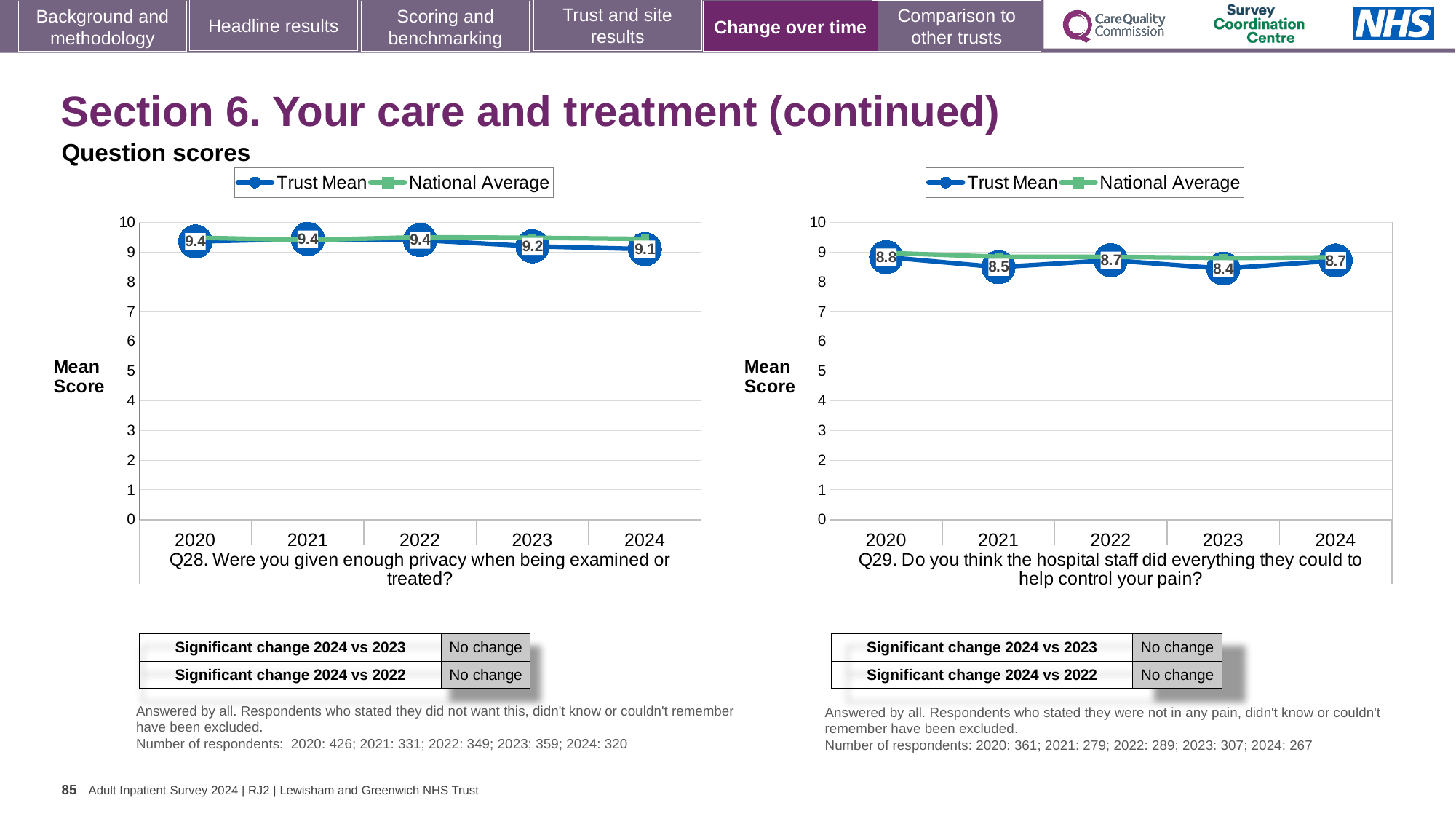
How many series does the legend of the Q28 chart (left) list? 2 How many years are plotted on the Q29 chart (right)? 5 On the Q29 chart (right), which is larger, the Trust Mean score for 2020 or for 2023? 2020 On the Q28 chart (left), does the Trust Mean score rise or fall from 2022 to 2024? Fall On the Q28 chart (left), what is the difference between the Trust Mean scores for 2020 and 2024? 0.3 On the Q29 chart (right), what is the Trust Mean score for 2021? 8.5 On the Q28 chart (left), is the National Average value for 2024 greater or less than 9? greater On the Q28 chart (left), what is the Trust Mean score for 2024? 9.1 What kind of chart is the Q28 chart (left)? Line chart On the Q29 chart (right), which year has the highest Trust Mean score? 2020 On the Q29 chart (right), which year has the lowest Trust Mean score? 2023 On the Q28 chart (left), which year has the lowest Trust Mean score? 2024